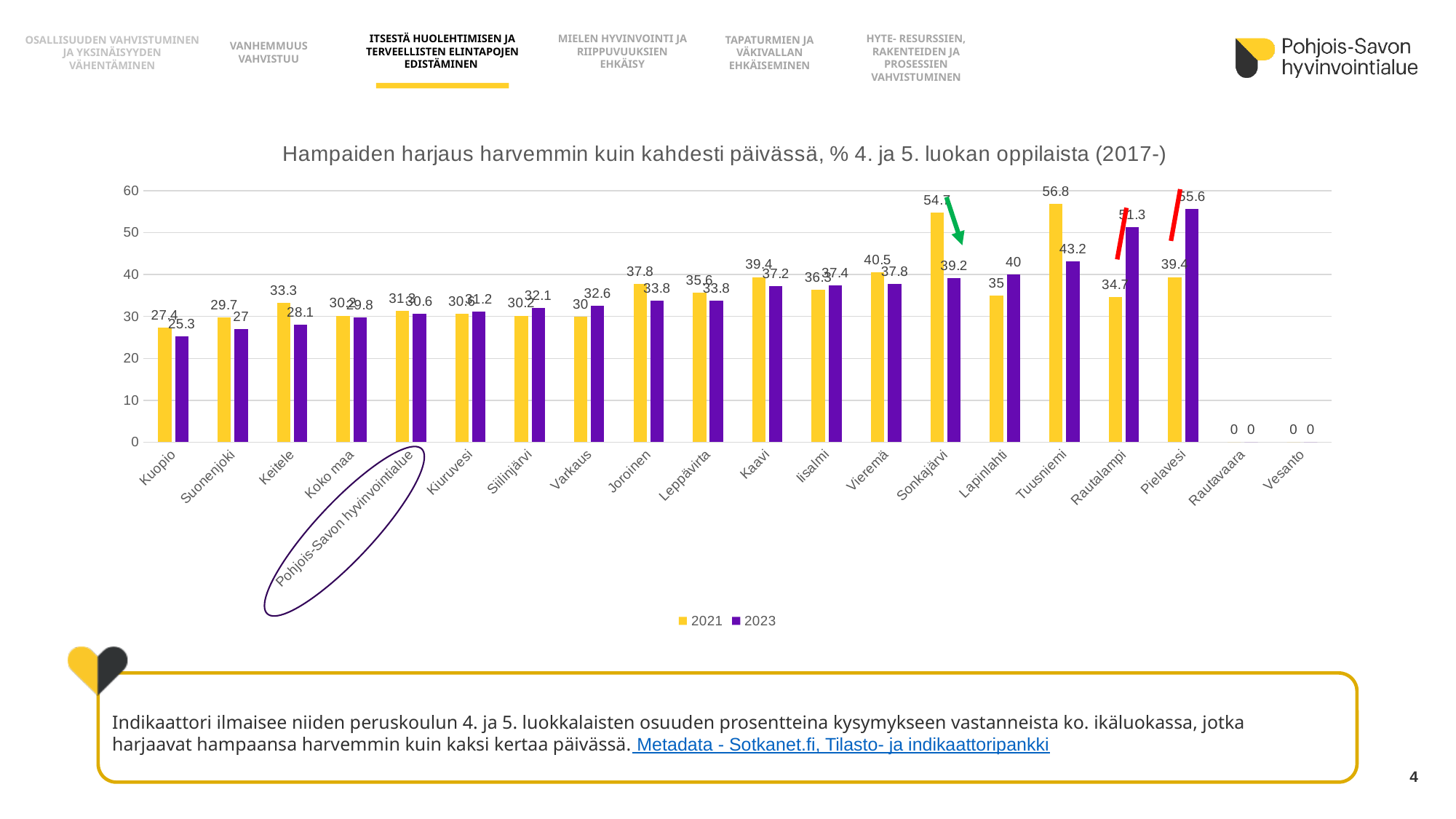
What kind of chart is shown on the slide? Bar chart What is the 2021 value for Kuopio? 27.4 What is the 2023 value for Rautalampi? 51.3 Which category has the highest 2021 value? Tuusniemi How many categories are shown on the x axis? 20 For Kaavi, which is larger, the 2021 value or the 2023 value? 2021 What is the difference between the 2023 and 2021 values for Lapinlahti? 5 What is the difference between the 2021 and 2023 values for Tuusniemi? 13.6 What is the 2021 value for Koko maa? 30.2 Which category has the highest 2023 value? Pielavesi What is the 2023 value for Pohjois-Savon hyvinvointialue? 30.6 How many series does the legend list? 2